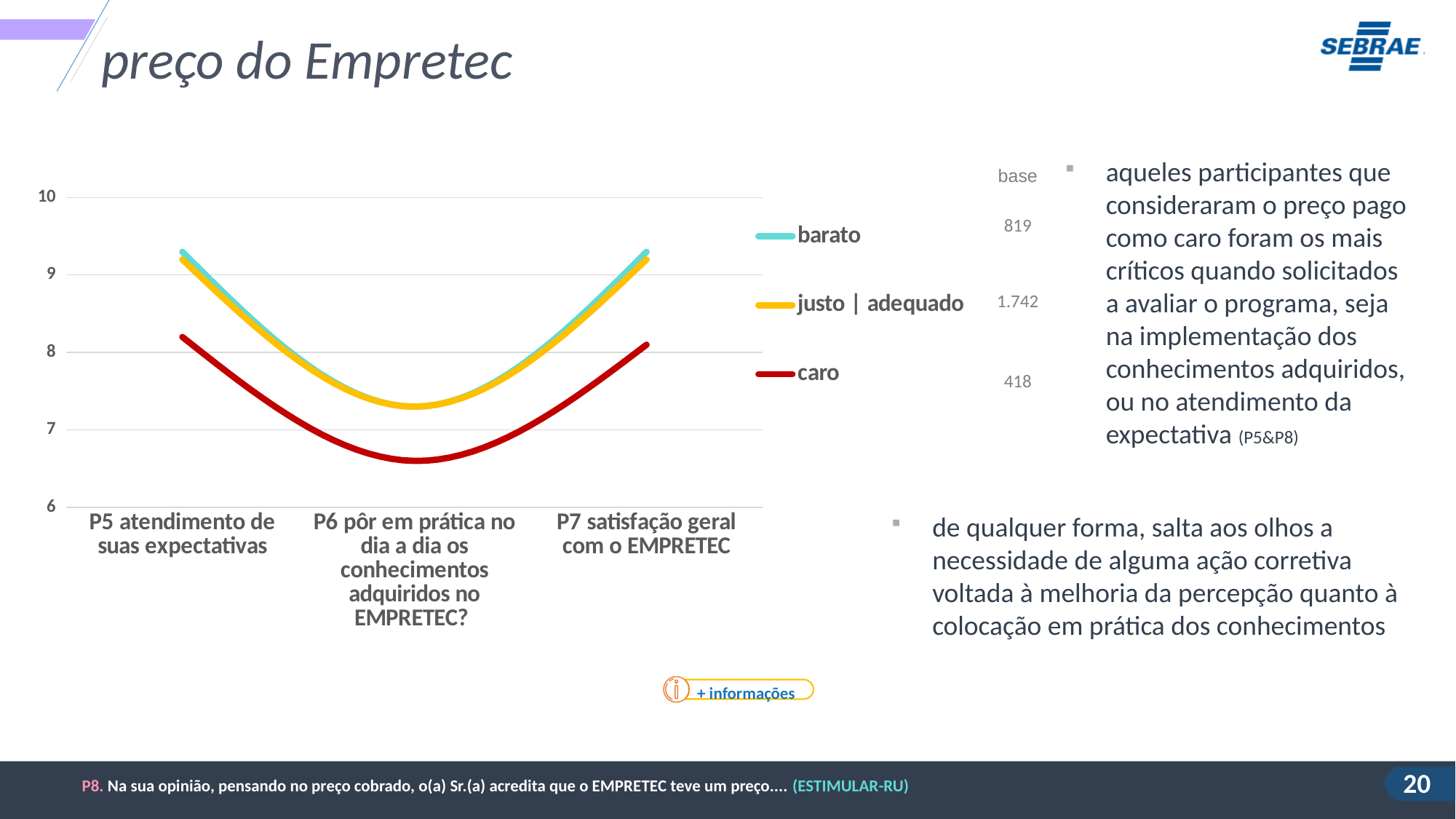
How many categories are shown on the x axis? 3 Is the value for justo | adequado at P6 greater or less than 7? greater Does the caro series rise or fall from P5 to P6? fall Is the value for barato at P5 atendimento de suas expectativas greater or less than 9? greater Is the value for caro at P6 greater or less than 7? less Which series is lowest at P6 pôr em prática no dia a dia os conhecimentos adquiridos no EMPRETEC? caro What base is shown next to the caro legend entry? 418 At P7 satisfação geral com o EMPRETEC, which is larger: barato or caro? barato What kind of chart is shown on the slide? line chart How many series does the legend list? 3 For the caro series, which category has the lowest value? P6 pôr em prática no dia a dia os conhecimentos adquiridos no EMPRETEC?